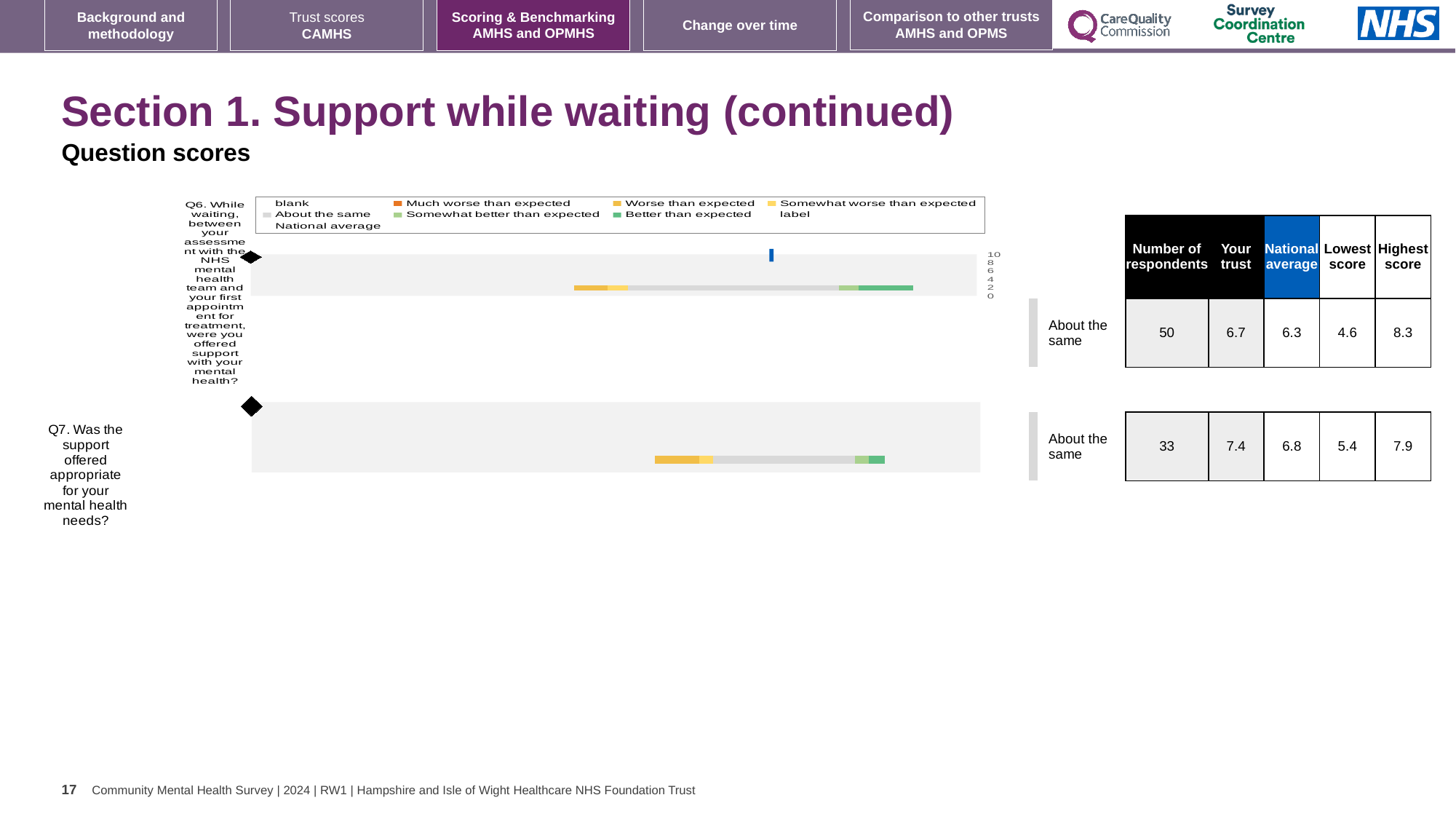
According to the table beside the chart, what is the highest score for Q6? 8.3 What is the maximum value shown on the chart's score axis? 10 What is the difference between the highest score and the lowest score for Q6 in the table beside the chart? 3.7 How many survey questions are plotted as bars in the chart? 2 What benchmark category is shown next to the chart for both Q6 and Q7? About the same Which question has more respondents in the table beside the chart, Q6 or Q7? Q6 According to the table beside the chart, what is the 'Your trust' score for Q6? 6.7 According to the table beside the chart, how many respondents answered Q7? 33 Which question has the higher 'Your trust' score in the table beside the chart, Q6 or Q7? Q7 What kind of chart is used to show the Q6 and Q7 question scores? bar chart By how much does the 'Your trust' score for Q7 exceed the national average for Q7 in the table beside the chart? 0.6 According to the table beside the chart, what is the national average score for Q7? 6.8